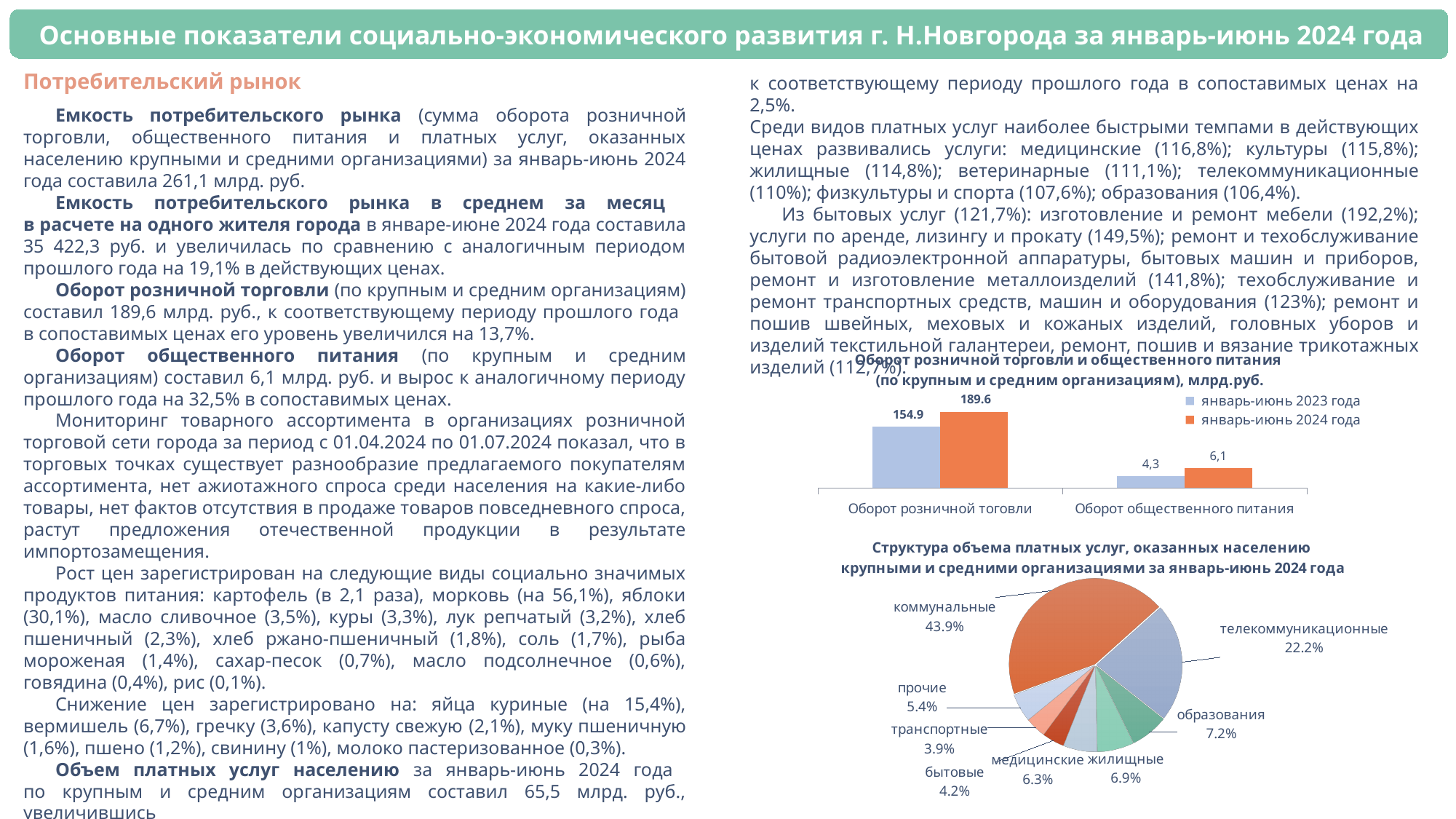
What kind of chart is 'Оборот розничной торговли и общественного питания'? bar chart In the pie chart 'Структура объема платных услуг', which category has the smallest share? транспортные In the pie chart 'Структура объема платных услуг', what is the difference between the shares of образования and жилищные? 0.3% How many series does the legend of the bar chart 'Оборот розничной торговли и общественного питания' list? 2 In the bar chart 'Оборот розничной торговли и общественного питания', which is larger for 'Оборот общественного питания': январь-июнь 2023 года or январь-июнь 2024 года? январь-июнь 2024 года In the bar chart 'Оборот розничной торговли и общественного питания', which colour represents январь-июнь 2024 года? orange In the pie chart 'Структура объема платных услуг', what is the share of телекоммуникационные services? 22.2% In the bar chart 'Оборот розничной торговли и общественного питания', what is the value for 'Оборот общественного питания' for январь-июнь 2023 года? 4,3 In the pie chart 'Структура объема платных услуг', what share do коммунальные services have? 43.9% How many slices does the pie chart 'Структура объема платных услуг' have? 8 In the bar chart 'Оборот розничной торговли и общественного питания', what is the value for 'Оборот розничной тоговли' for январь-июнь 2024 года? 189.6 In the bar chart 'Оборот розничной торговли и общественного питания', what is the difference between the 2024 and 2023 values for 'Оборот розничной тоговли'? 34.7